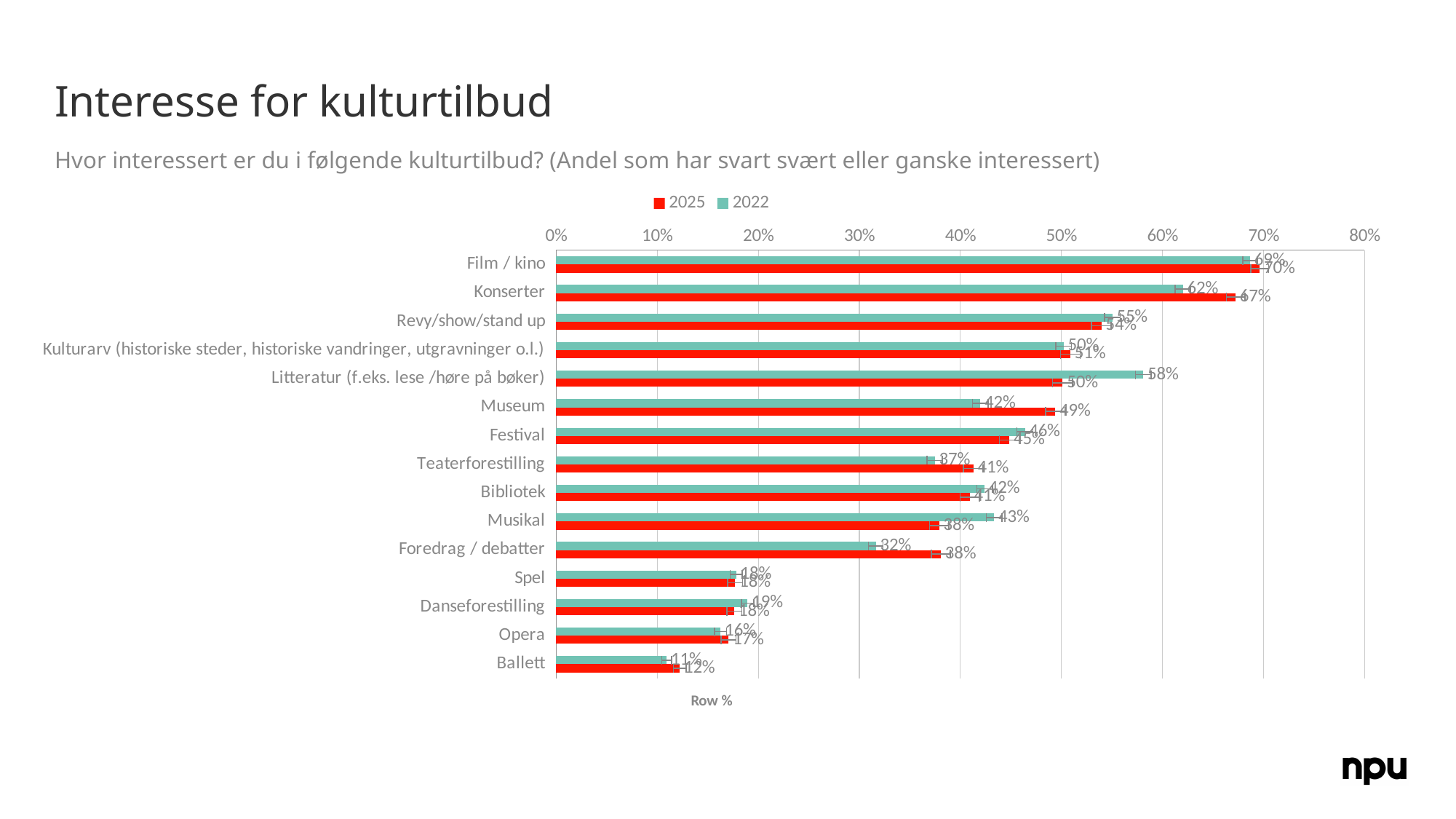
Which series is shown in red? 2025 What type of chart is shown on the slide? bar chart What is the 2022 value for Foredrag / debatter? 32% What is the difference between the 2025 and 2022 values for Konserter? 5% For Museum, which is larger: the 2025 value or the 2022 value? 2025 How many series does the legend list? 2 Which category has the highest 2025 value? Film / kino Is the 2022 value for Musikal greater or less than 40%? greater What is the 2022 value for Litteratur (f.eks. lese /høre på bøker)? 58% Which category has the lowest 2022 value? Ballett What is the 2025 value for Museum? 49% How many categories are shown on the chart? 15